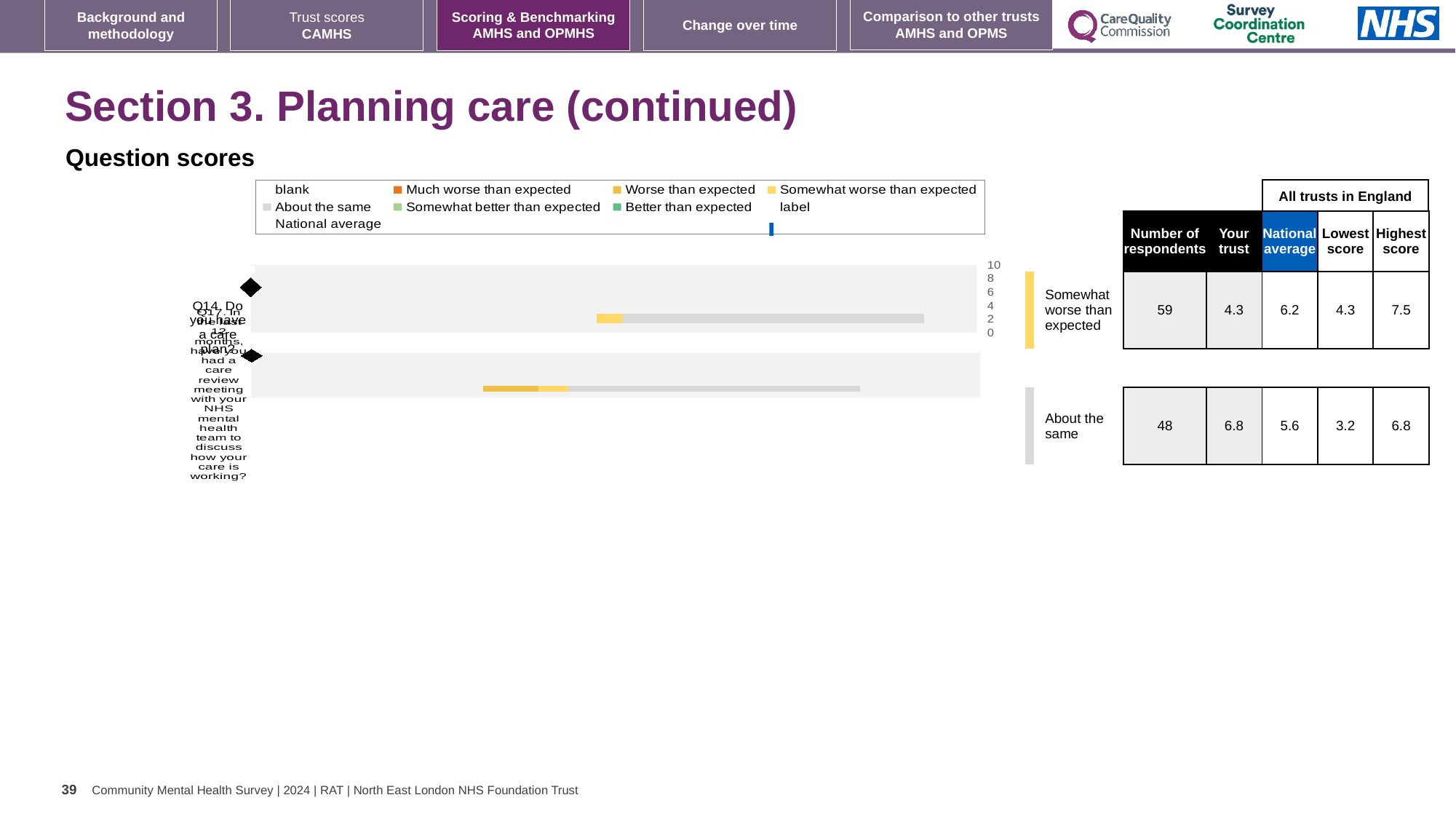
What is the highest score across all trusts in England for the question rated 'Somewhat worse than expected'? 7.5 What is the 'Your trust' score for the question rated 'About the same'? 6.8 How many respondents are listed for the question rated 'Somewhat worse than expected'? 59 For the question rated 'Somewhat worse than expected', how much higher is the national average than the 'Your trust' score? 1.9 What kind of chart is shown under 'Question scores'? bar chart Which question has the higher 'Your trust' score: the one rated 'Somewhat worse than expected' or the one rated 'About the same'? About the same What is the national average for the question rated 'Somewhat worse than expected'? 6.2 What is the lowest score across all trusts in England for the question rated 'About the same'? 3.2 How many question bars are plotted in the chart? 2 For the question rated 'About the same', what is the difference between the highest score and the lowest score? 3.6 In the chart legend, what colour marks 'Much worse than expected'? orange What rating label is shown beside the first (top) bar of the chart? Somewhat worse than expected